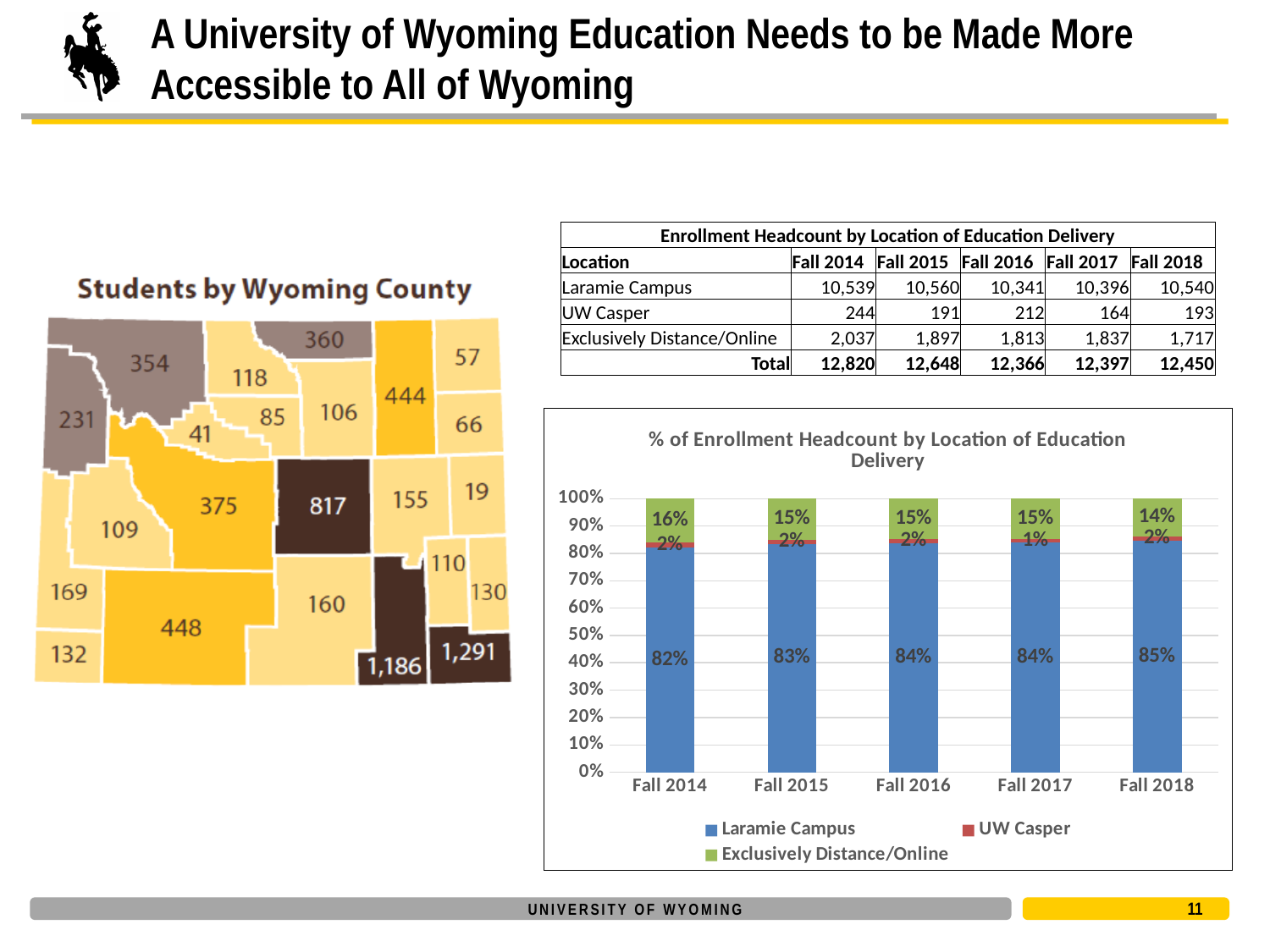
What kind of chart is the '% of Enrollment Headcount by Location of Education Delivery' chart? Stacked bar chart In the '% of Enrollment Headcount by Location of Education Delivery' chart, which is larger: the Exclusively Distance/Online share in Fall 2014 or in Fall 2018? Fall 2014 In the '% of Enrollment Headcount by Location of Education Delivery' chart, what is the Exclusively Distance/Online value for Fall 2018? 14% In the '% of Enrollment Headcount by Location of Education Delivery' chart, which year has the lowest Exclusively Distance/Online share? Fall 2018 In the '% of Enrollment Headcount by Location of Education Delivery' chart, which year has the highest Laramie Campus share? Fall 2018 How many years (categories) are shown on the x axis of the '% of Enrollment Headcount by Location of Education Delivery' chart? 5 In the '% of Enrollment Headcount by Location of Education Delivery' chart, what is the Laramie Campus value for Fall 2014? 82% In the '% of Enrollment Headcount by Location of Education Delivery' chart, what is the difference between the Laramie Campus share in Fall 2018 and in Fall 2014? 3% In the '% of Enrollment Headcount by Location of Education Delivery' chart, does the Laramie Campus share rise or fall from Fall 2014 to Fall 2018? Rise How many series does the legend of the '% of Enrollment Headcount by Location of Education Delivery' chart list? 3 In the '% of Enrollment Headcount by Location of Education Delivery' chart, what is the UW Casper value for Fall 2017? 1% In the '% of Enrollment Headcount by Location of Education Delivery' chart, is the Laramie Campus value for Fall 2016 greater or less than 80%? greater